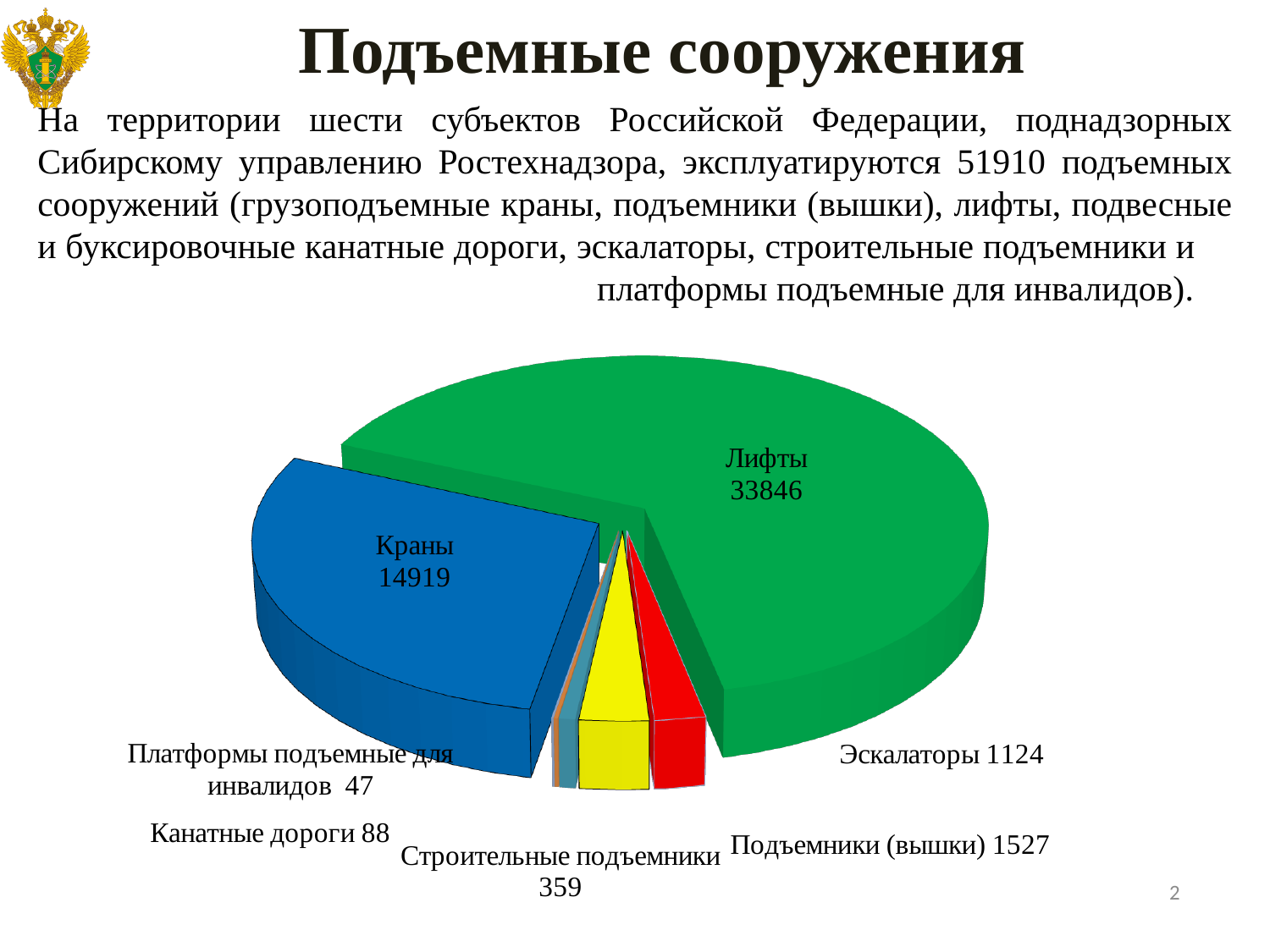
How many lifts (Лифты) are shown on the pie chart? 33846 What is the difference between the values for Подъемники (вышки) and Эскалаторы? 403 What type of chart is shown on the slide? Pie chart What value is shown for Подъемники (вышки) on the pie chart? 1527 Which is larger, the value for Строительные подъемники or the value for Эскалаторы? Эскалаторы What value is shown for Эскалаторы on the pie chart? 1124 What value is shown for Краны on the pie chart? 14919 Which category has the largest slice of the pie chart? Лифты What is the difference between the values for Лифты and Краны? 18927 Which category has the smallest value on the pie chart? Платформы подъемные для инвалидов How many categories are shown on the pie chart? 7 What value is shown for Канатные дороги on the pie chart? 88